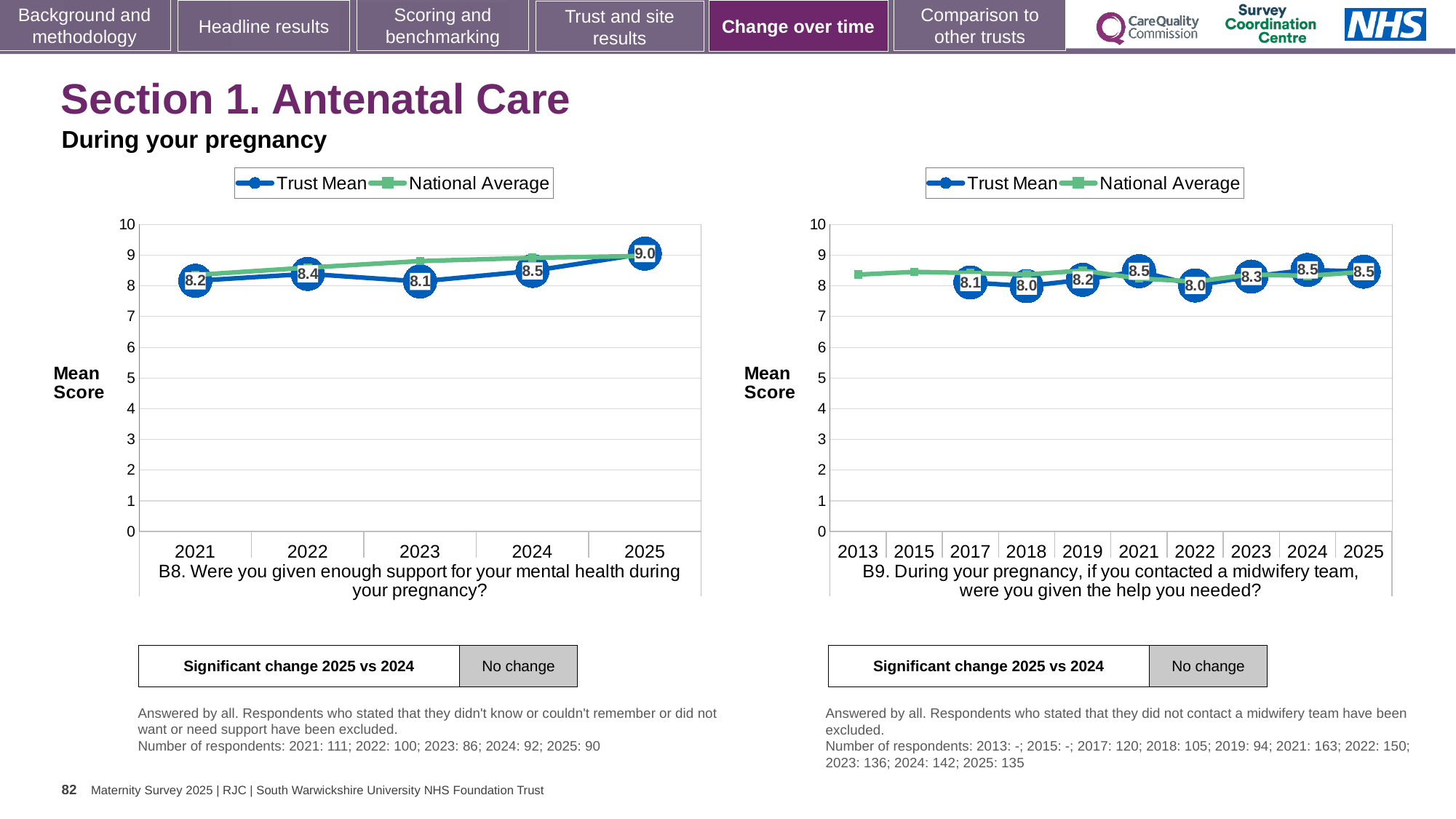
On the right chart (B9), how many series does the legend list? 2 On the left chart (B8), how many years are shown on the x axis? 5 On the left chart (B8), what is the difference between the Trust Mean for 2025 and the Trust Mean for 2024? 0.5 On the right chart (B9), how many years are shown on the x axis? 10 On the left chart (B8), what is the Trust Mean for 2025? 9.0 On the right chart (B9), what is the Trust Mean for 2022? 8.0 On the right chart (B9), what is the Trust Mean for 2021? 8.5 What type of chart is the left chart (B8)? Line chart On the left chart (B8), which year has the lowest Trust Mean? 2023 On the left chart (B8), which year has the highest Trust Mean? 2025 On the right chart (B9), is the Trust Mean for 2019 larger or smaller than the Trust Mean for 2018? larger On the left chart (B8), what is the Trust Mean for 2023? 8.1